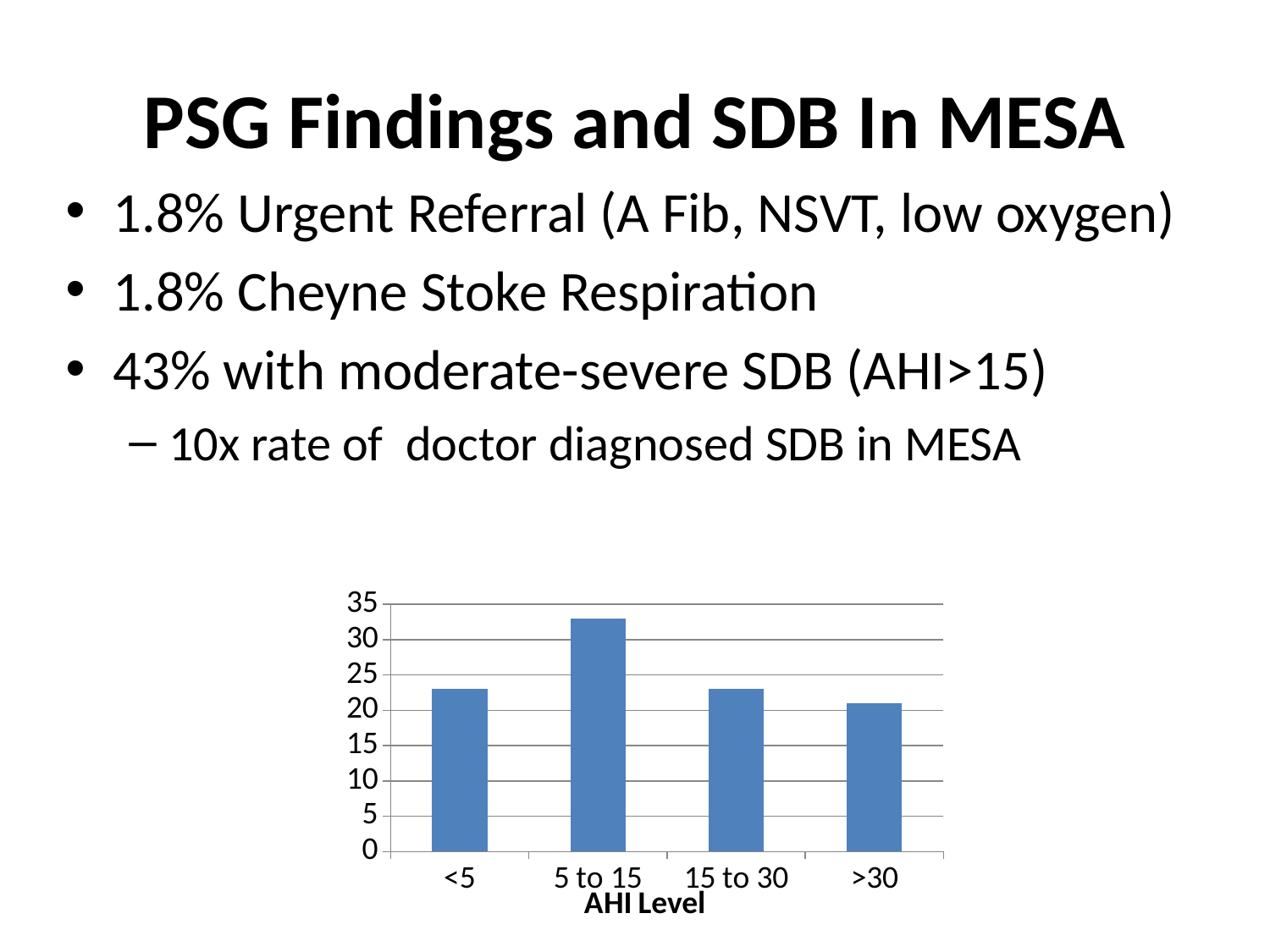
What is the highest value shown on the y axis of the chart? 35 Is the value for the 5 to 15 AHI Level greater or less than 30? greater Is the value for the <5 AHI Level greater or less than 20? greater Is the value for the 5 to 15 AHI Level greater or less than 35? less Which AHI Level category has the highest bar? 5 to 15 Which is larger, the value for 5 to 15 or the value for >30? 5 to 15 How many AHI Level categories are plotted in the chart? 4 Which is larger, the value for <5 or the value for 5 to 15? 5 to 15 What is the title of the x axis of the chart? AHI Level What kind of chart is shown on the slide? bar chart